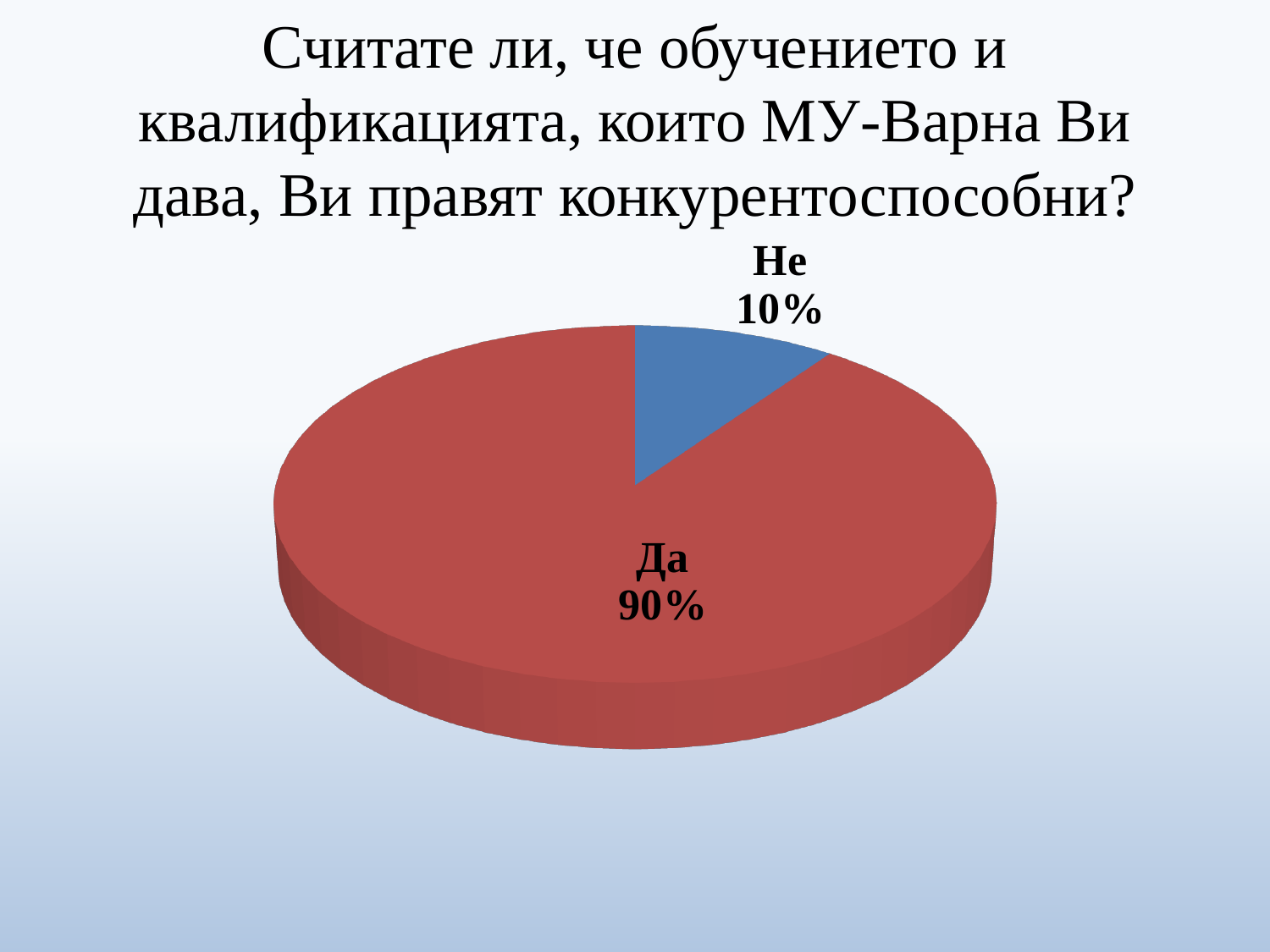
Which category has the largest slice of the pie? Да What share of the pie does "Не" represent? 10% What is the difference in percentage points between the "Да" and "Не" slices? 80 Which slice is larger, "Да" or "Не"? Да What colour is the "Да" slice? Red How many slices does the pie chart have? 2 Which category has the smallest slice of the pie? Не What colour is the "Не" slice? Blue What share of the pie does "Да" represent? 90% What kind of chart is shown on the slide? Pie chart